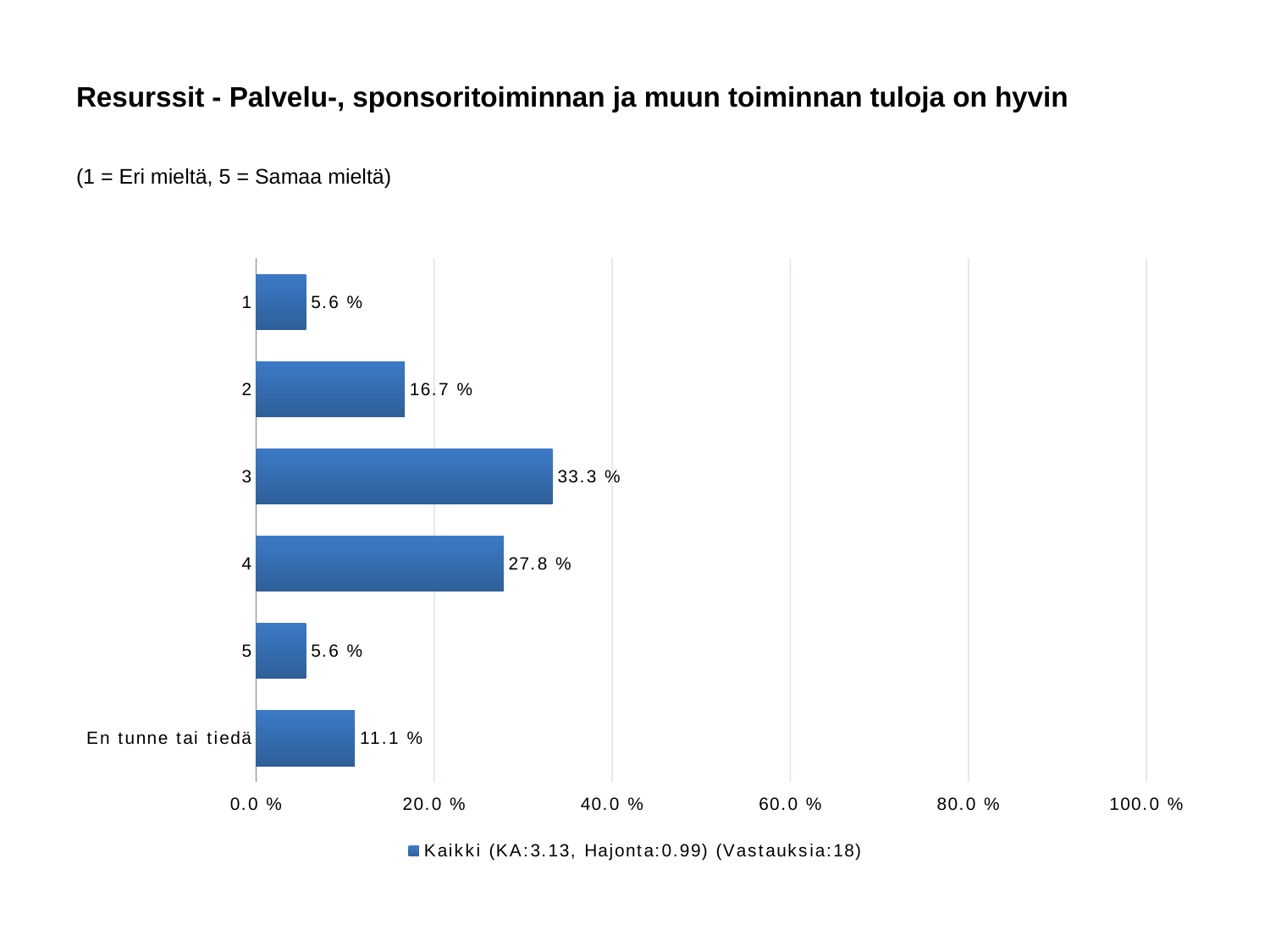
How many series does the legend list? 1 How many categories are shown on the chart? 6 What is the difference between the values for category 4 and category 5? 22.2 % Which is larger, the value for category 2 or the value for category 4? 4 What kind of chart is shown on the slide? bar chart How many responses (Vastauksia) does the legend entry report? 18 What is the value for "En tunne tai tiedä"? 11.1 % What is the value for category 3? 33.3 % What is the difference between the values for category 3 and category 4? 5.5 % What is the value for category 2? 16.7 % Which category has the highest value? 3 Is the value for category 3 greater or less than 40.0 %? less